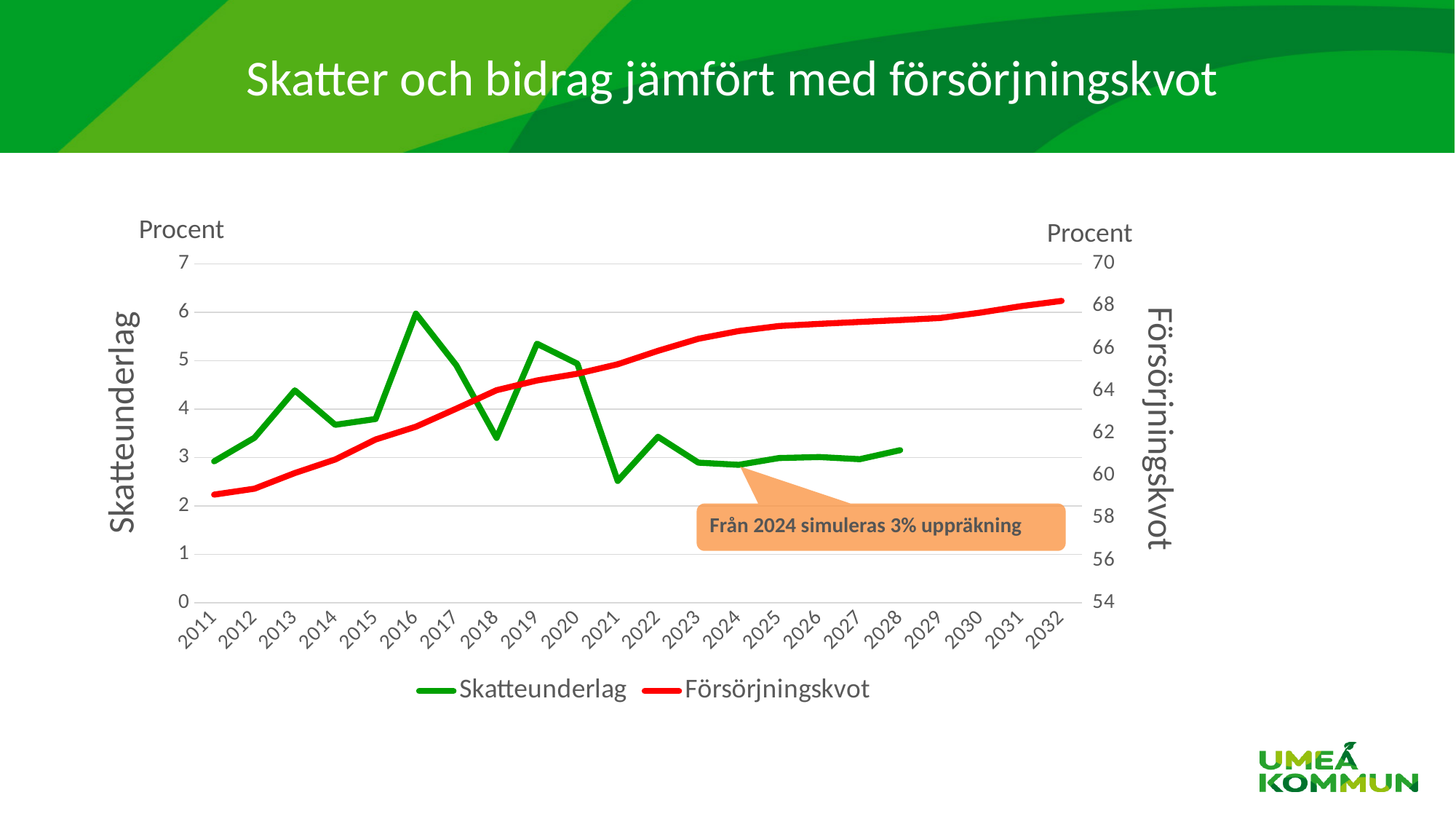
Is the value for Försörjningskvot in 2032 greater or less than 66? greater How many series does the legend list? 2 Is the value for Försörjningskvot in 2011 greater or less than 60? less Is the value for Skatteunderlag in 2016 greater or less than 5? greater In which year is Skatteunderlag at its highest? 2016 What does the orange callout on the chart say? Från 2024 simuleras 3% uppräkning In which year is Skatteunderlag at its lowest? 2021 What kind of chart is shown on the slide? Line chart In which year is Försörjningskvot at its highest? 2032 Does Försörjningskvot rise or fall from 2011 to 2032? Rise How many years are shown on the x axis? 22